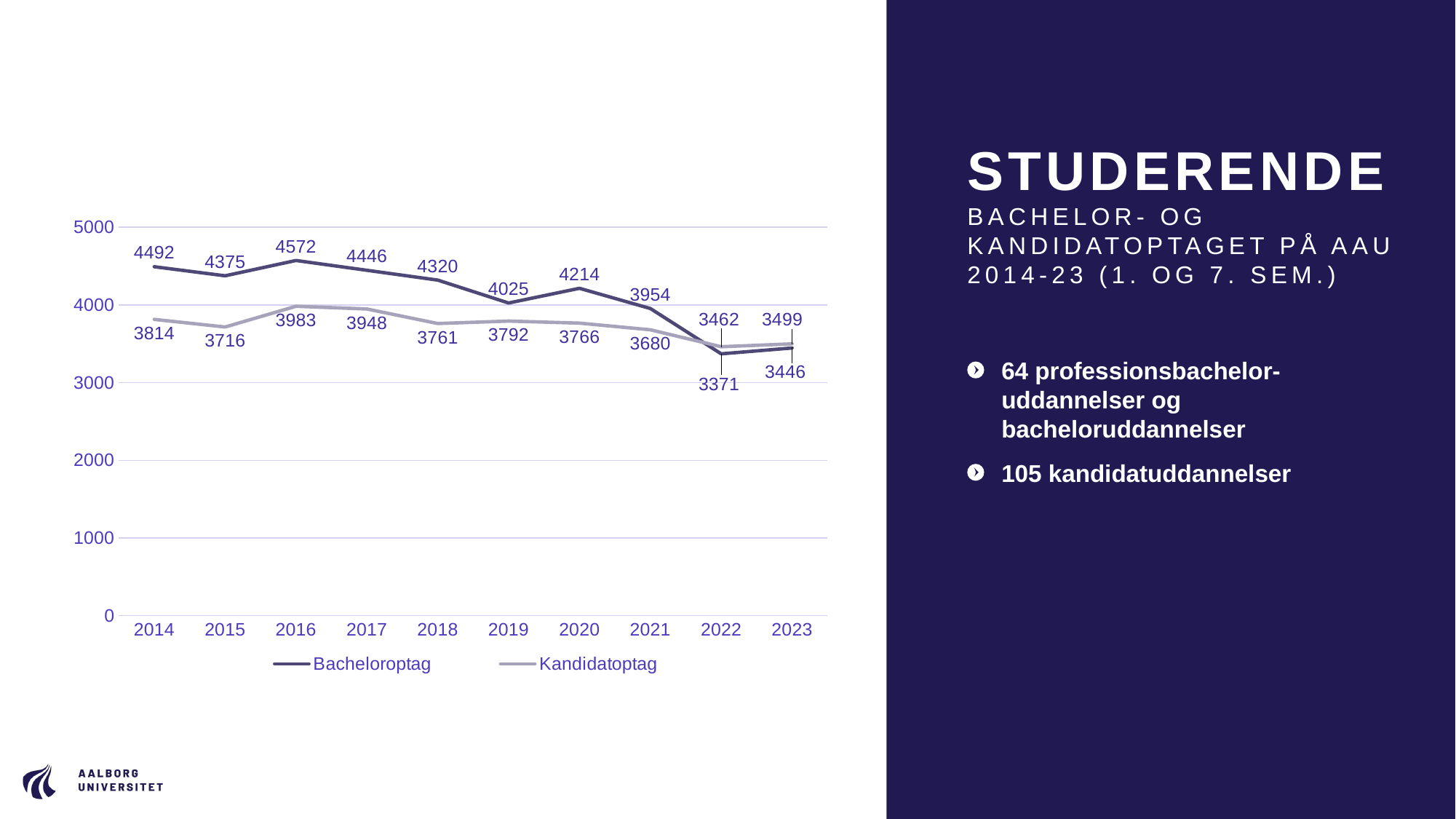
What kind of chart is shown on the slide? Line chart How many years are shown on the x axis? 10 In 2022, which series has the larger value, Bacheloroptag or Kandidatoptag? Kandidatoptag In which year is Kandidatoptag lowest? 2022 How many series does the legend list? 2 What is the Bacheloroptag value for 2016? 4572 In which year is Bacheloroptag highest? 2016 What is the Kandidatoptag value for 2019? 3792 Does the Bacheloroptag series overall rise or fall from 2014 to 2023? Fall What is the difference between the Bacheloroptag values for 2014 and 2023? 1046 In which year is Bacheloroptag lowest? 2022 In which year is Kandidatoptag highest? 2016